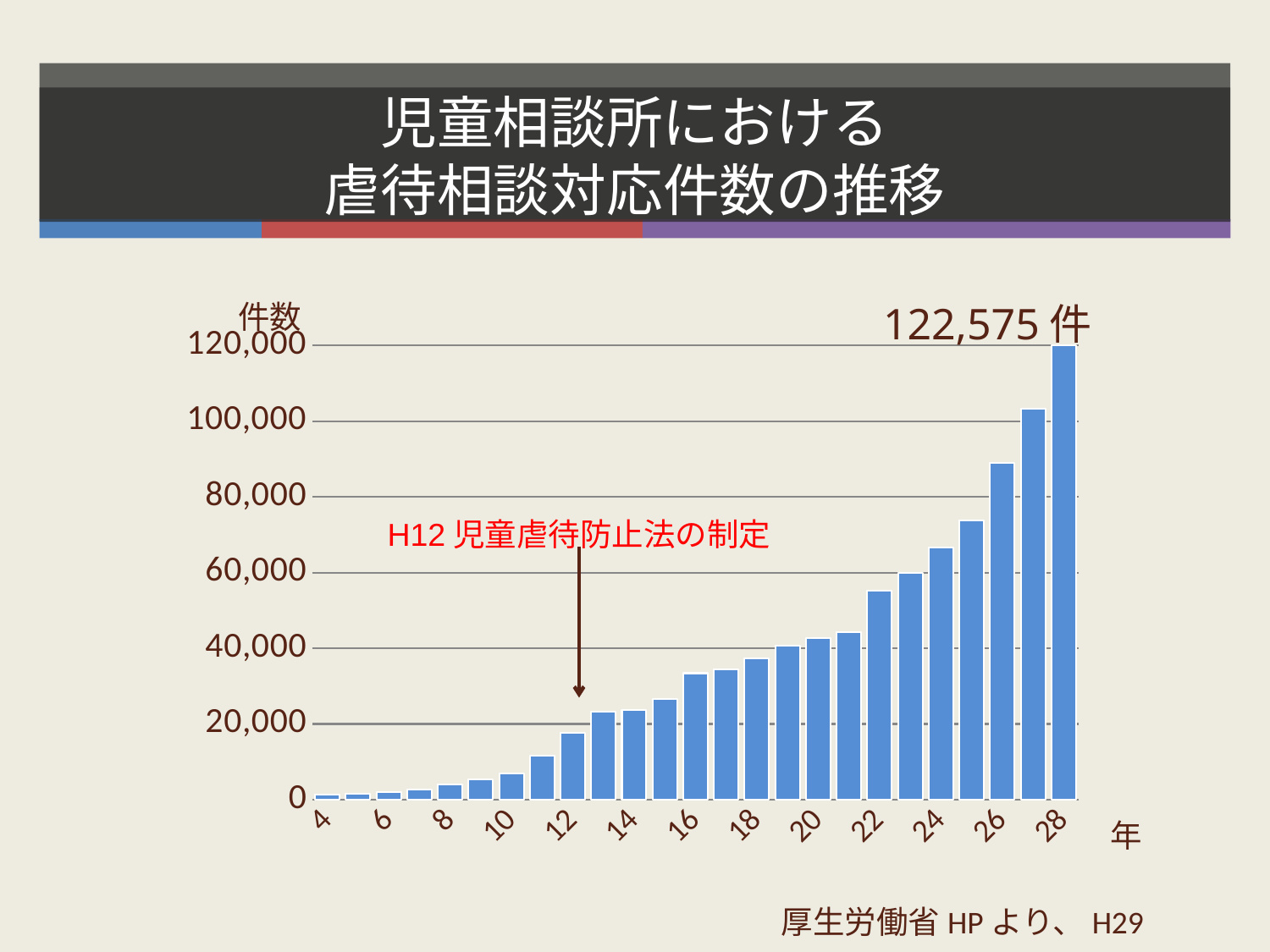
Which year has the highest number of cases? 28 How many bars are plotted in the chart? 25 Is the value for year 12 greater or less than 20,000? less Which is larger, the value for year 26 or the value for year 22? year 26 Is the value for year 22 greater or less than 40,000? greater Do the values rise or fall as the years increase along the x axis? rise Is the value for year 18 greater or less than 40,000? less What kind of chart is shown on the slide? bar chart What event does the red annotation with the arrow mark on the chart? H12 児童虐待防止法の制定 What value is labelled on the bar for year 28? 122,575 件 Which year has the lowest number of cases? 4